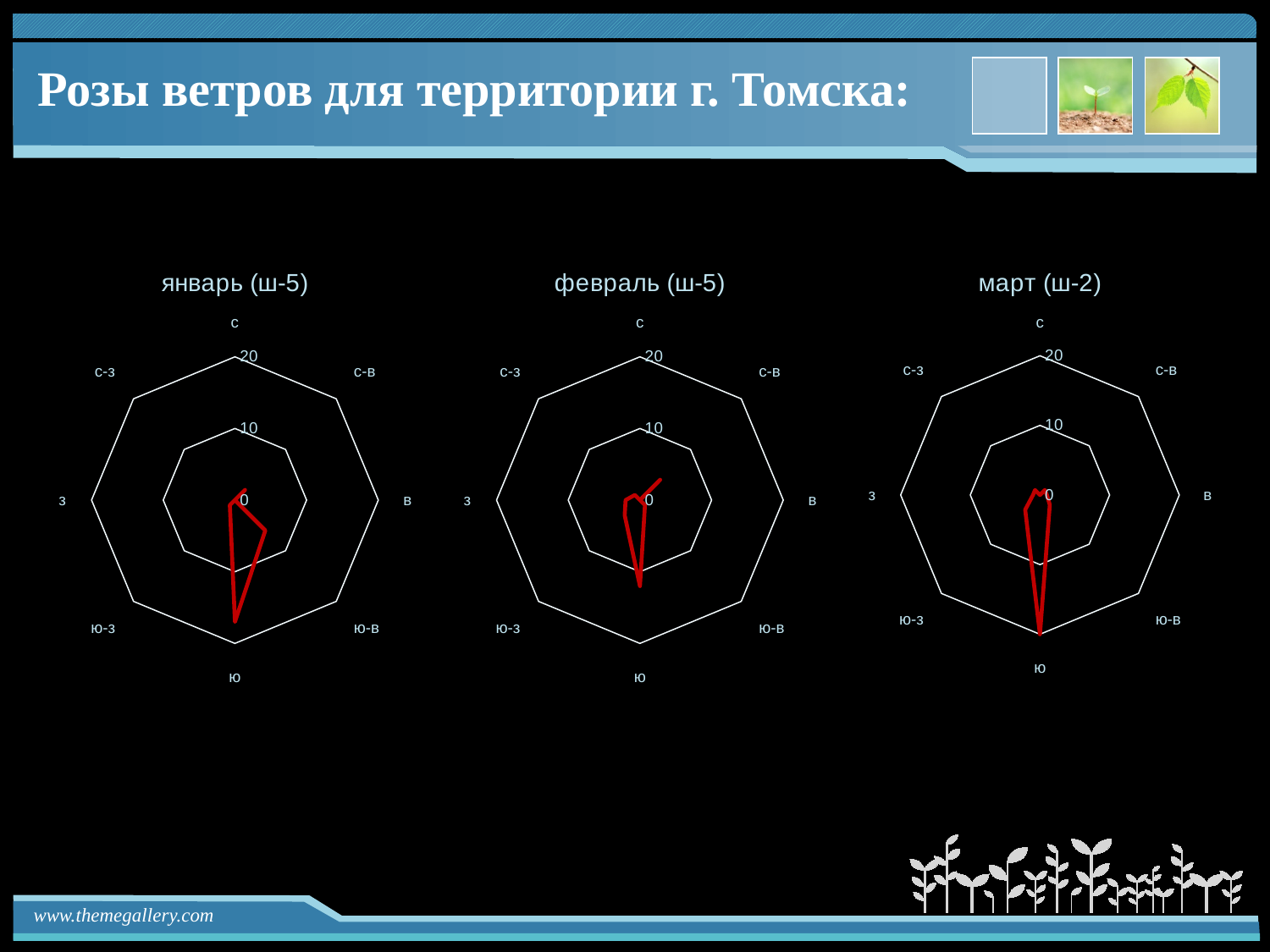
What kind of chart is the "январь (ш-5)" chart? radar chart In the "январь (ш-5)" chart, which direction has the highest value? ю In the "март (ш-2)" chart, which direction has the highest value? ю In the "январь (ш-5)" chart, is the value for ю-в greater or less than 10? less In the "март (ш-2)" chart, is the value for ю greater or less than 10? greater In the "февраль (ш-5)" chart, which direction has the highest value? ю How many charts are shown on the slide? 3 In the "январь (ш-5)" chart, which is larger, the value for ю or the value for ю-в? ю How many direction categories does the "март (ш-2)" chart have? 8 What is the title of the middle chart on the slide? февраль (ш-5) In the "март (ш-2)" chart, which is larger, the value for ю or the value for с-з? ю In the "февраль (ш-5)" chart, is the value for ю greater or less than 10? greater